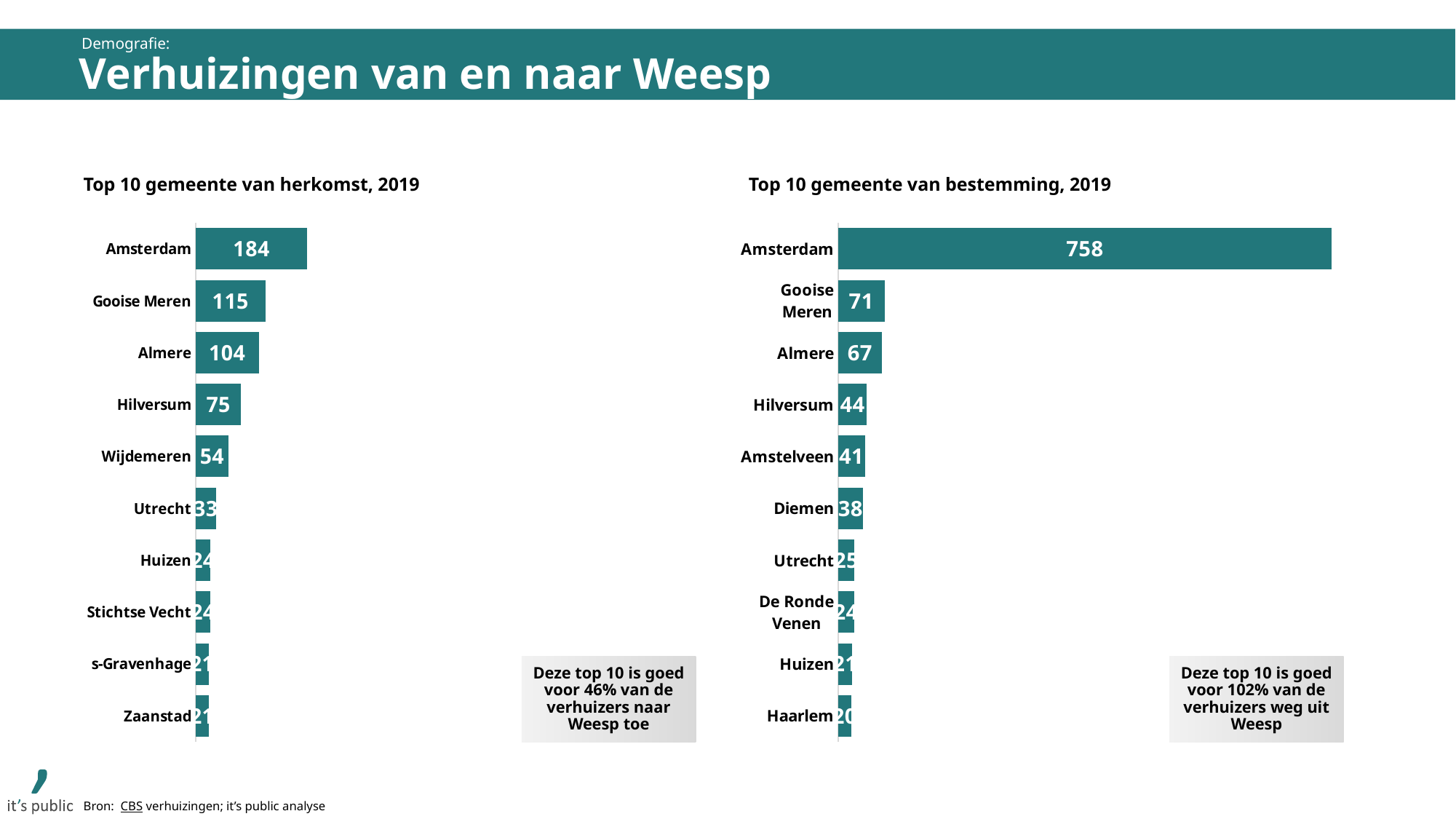
In the chart 'Top 10 gemeente van bestemming, 2019', what is the difference between the values for Gooise Meren and Almere? 4 In the chart 'Top 10 gemeente van bestemming, 2019', what is the value for Amsterdam? 758 What type of chart is 'Top 10 gemeente van herkomst, 2019'? Bar chart How many municipalities are shown in the chart 'Top 10 gemeente van bestemming, 2019'? 10 In the chart 'Top 10 gemeente van bestemming, 2019', what is the value for Diemen? 38 In the chart 'Top 10 gemeente van herkomst, 2019', what is the value for Amsterdam? 184 According to the text box next to the chart 'Top 10 gemeente van bestemming, 2019', what share of the movers leaving Weesp does this top 10 account for? 102% In the chart 'Top 10 gemeente van herkomst, 2019', what is the value for Almere? 104 In the chart 'Top 10 gemeente van bestemming, 2019', which municipality has the highest value? Amsterdam In the chart 'Top 10 gemeente van herkomst, 2019', what is the difference between the values for Gooise Meren and Almere? 11 In the chart 'Top 10 gemeente van bestemming, 2019', what is the value for Hilversum? 44 Which is larger: the value for Hilversum in the chart 'Top 10 gemeente van herkomst, 2019' or the value for Hilversum in the chart 'Top 10 gemeente van bestemming, 2019'? Top 10 gemeente van herkomst, 2019